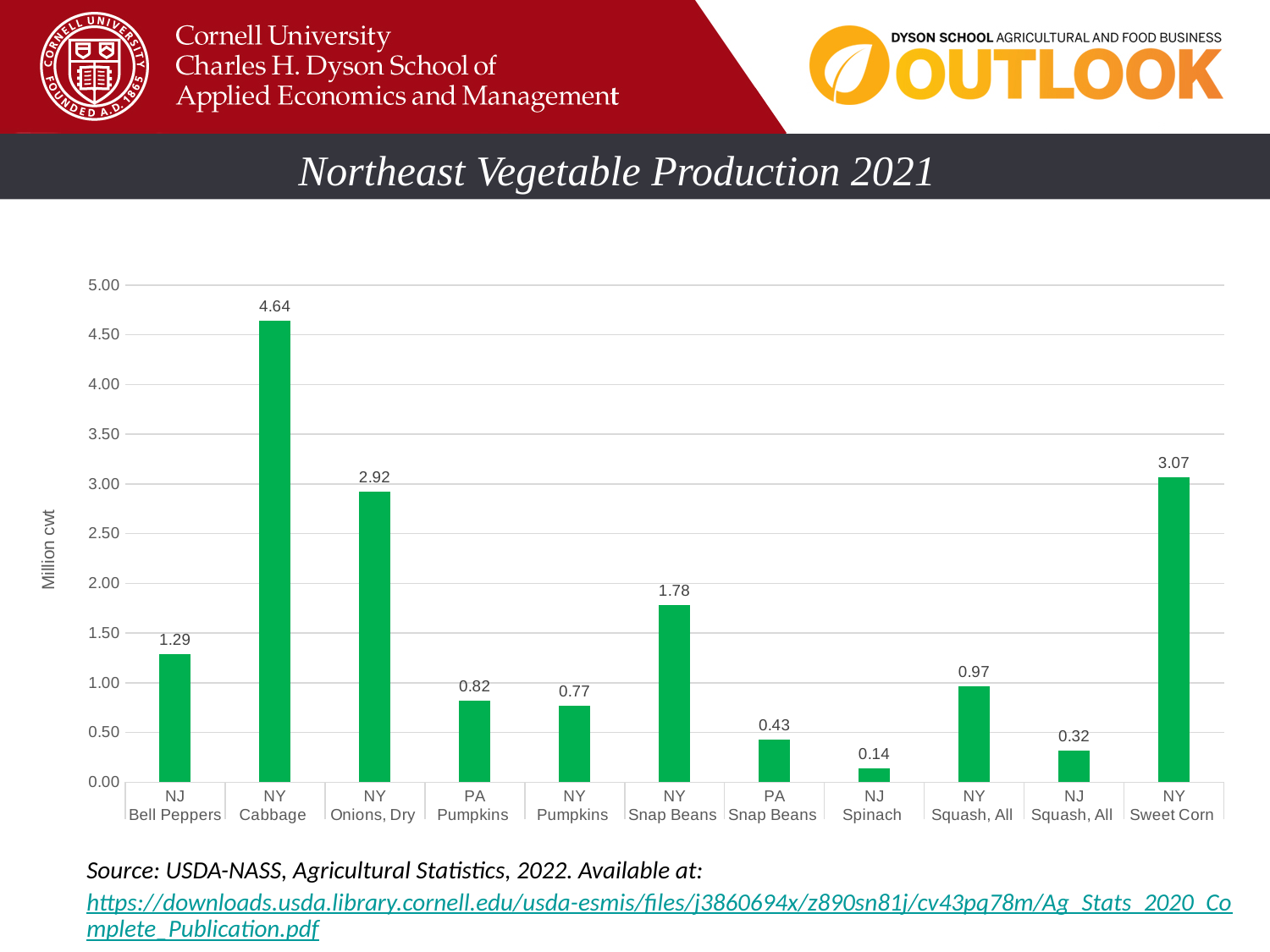
What is the difference between PA Pumpkins and NY Pumpkins? 0.05 Which category has the lowest value? NJ Spinach What is the value for NJ Spinach? 0.14 Which category has the highest value? NY Cabbage How many categories are shown on the chart? 11 What kind of chart is shown? Bar chart What is the value for NY Sweet Corn? 3.07 What is the value for NY Cabbage? 4.64 What is the y-axis label of the chart? Million cwt What is the difference between NY Cabbage and NY Onions, Dry? 1.72 Which is larger, NY Squash, All or NJ Squash, All? NY Squash, All Which is larger, NY Snap Beans or PA Snap Beans? NY Snap Beans